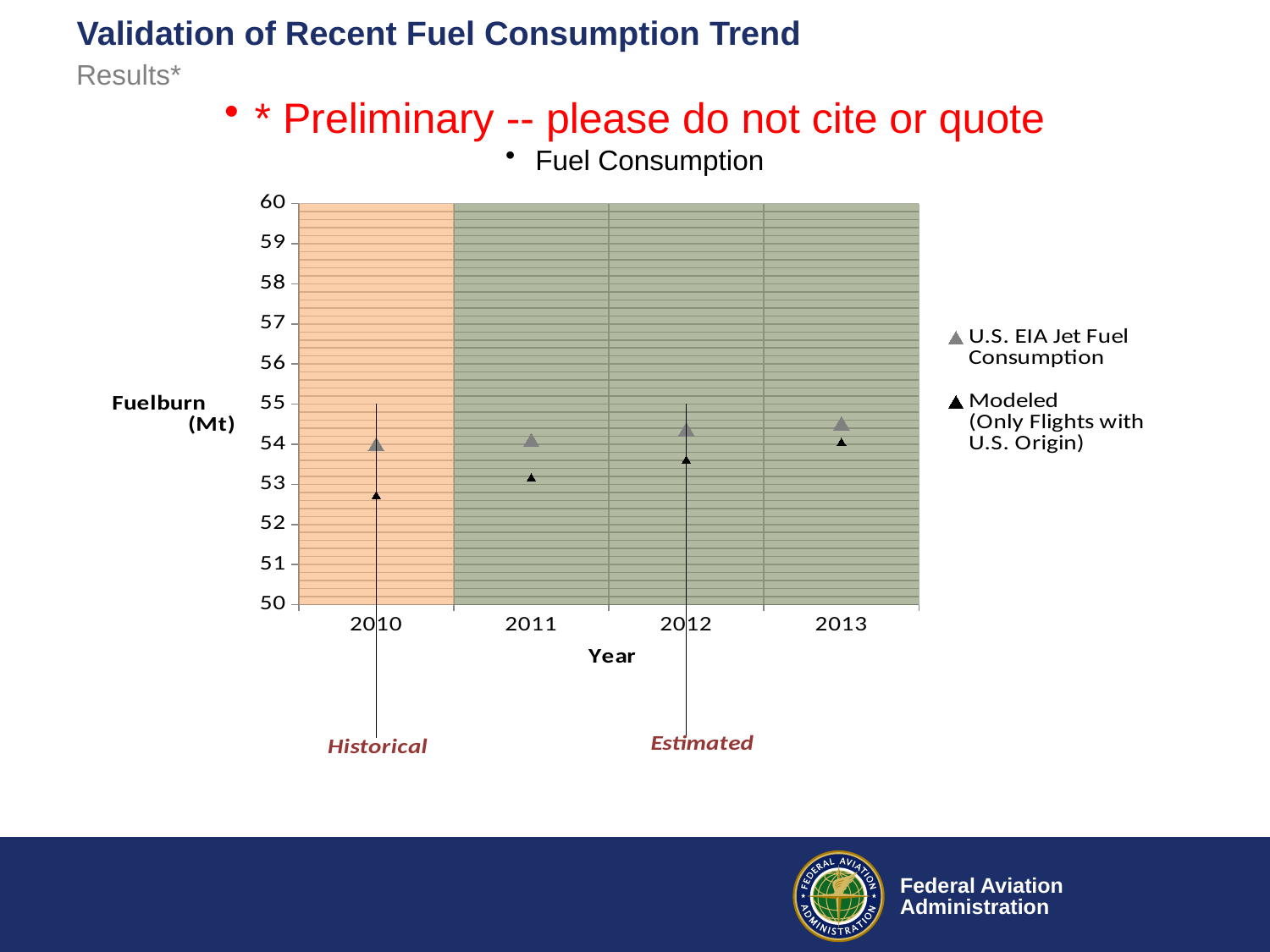
How many years are plotted along the x axis? 4 In which year is the Modeled (Only Flights with U.S. Origin) value highest? 2013 Is the Modeled (Only Flights with U.S. Origin) value for 2010 greater or less than 53? less In which year is the Modeled (Only Flights with U.S. Origin) value lowest? 2010 Is the Modeled (Only Flights with U.S. Origin) value for 2012 greater or less than 54? less Do the Modeled (Only Flights with U.S. Origin) values rise or fall from 2010 to 2013? rise How many series does the legend list? 2 What is the label on the y axis? Fuelburn (Mt) In 2010, which series has the larger value: U.S. EIA Jet Fuel Consumption or Modeled (Only Flights with U.S. Origin)? U.S. EIA Jet Fuel Consumption What kind of chart is shown on the slide? scatter chart What is the title of the chart? Fuel Consumption Is the U.S. EIA Jet Fuel Consumption value for 2013 greater or less than 54? greater